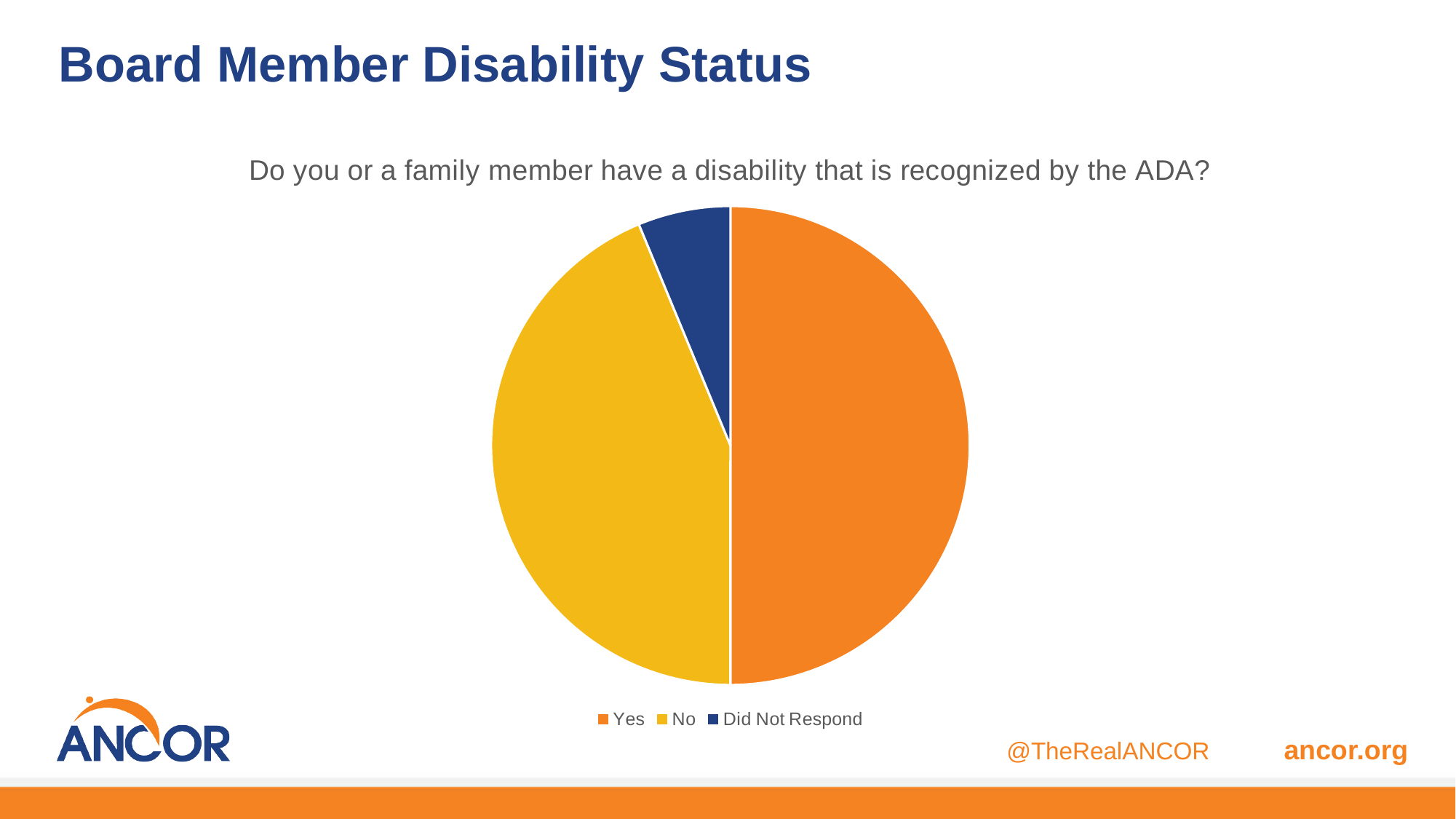
Which slice is larger, No or Did Not Respond? No How many slices does the pie chart have? 3 Which response category has the largest slice of the pie? Yes What kind of chart is shown on the slide? pie chart What question is shown as the title of the pie chart? Do you or a family member have a disability that is recognized by the ADA? What colour is the Did Not Respond slice? dark blue Which slice is larger, Yes or No? Yes How many entries does the legend list? 3 Which response category has the smallest slice of the pie? Did Not Respond